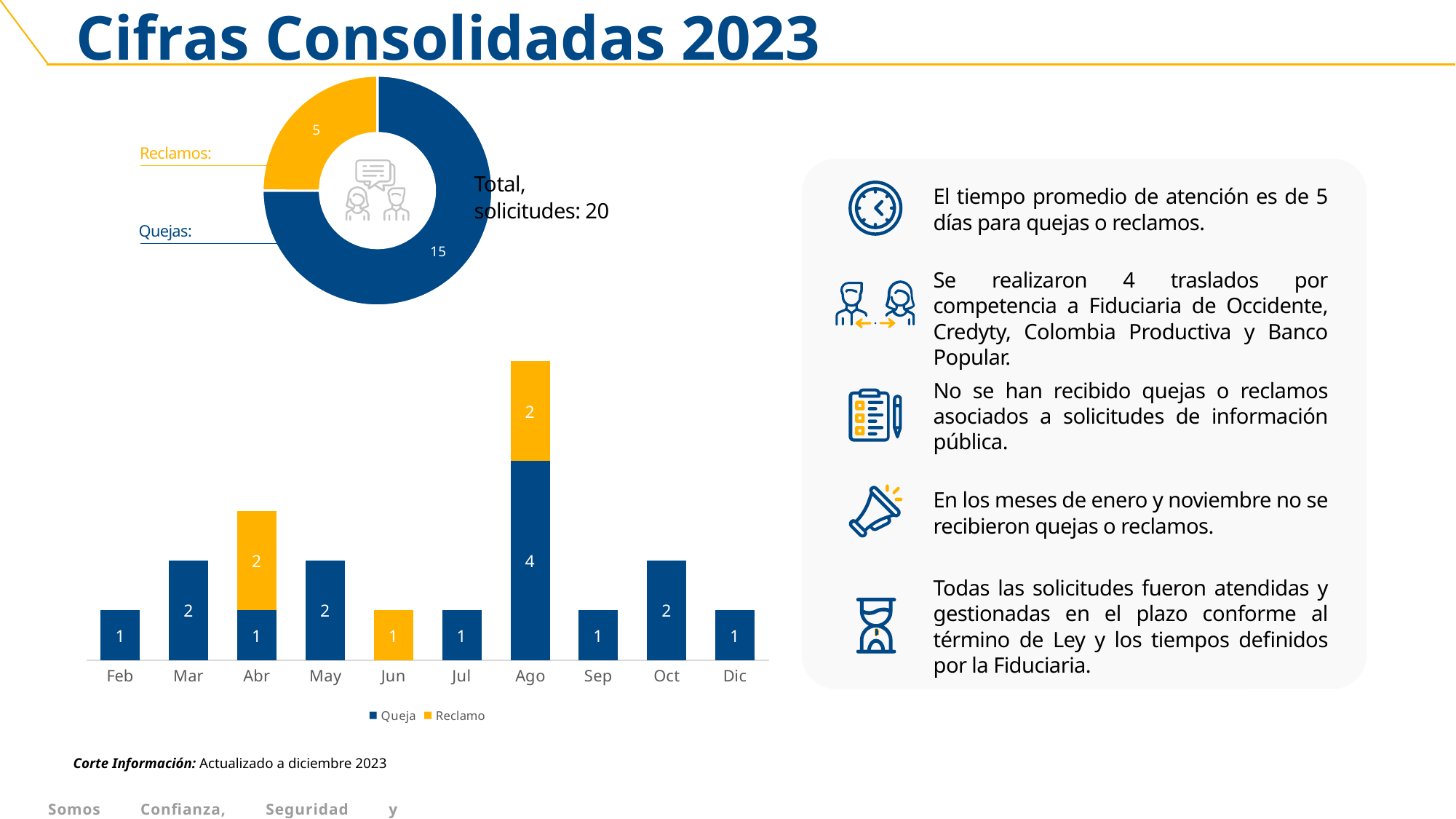
In the monthly bar chart, what is the Queja value for Ago? 4 In the donut chart at the top left, what is the value for Reclamos? 5 In the monthly bar chart, what is the Reclamo value for Abr? 2 In the monthly bar chart, how many series does the legend list? 2 In the donut chart at the top left, what share of the total do Reclamos represent? 25% In the monthly bar chart, which is larger: the Queja value for Mar or the Queja value for Jul? Mar In the monthly bar chart, what is the total of the stacked bar for Abr? 3 In the donut chart at the top left, what is the difference between Quejas and Reclamos? 10 In the monthly bar chart, which month has the highest total? Ago In the donut chart at the top left, what is the value for Quejas? 15 In the monthly bar chart, how many months are shown on the x axis? 10 In the monthly bar chart, what is the total of the stacked bar for Ago? 6